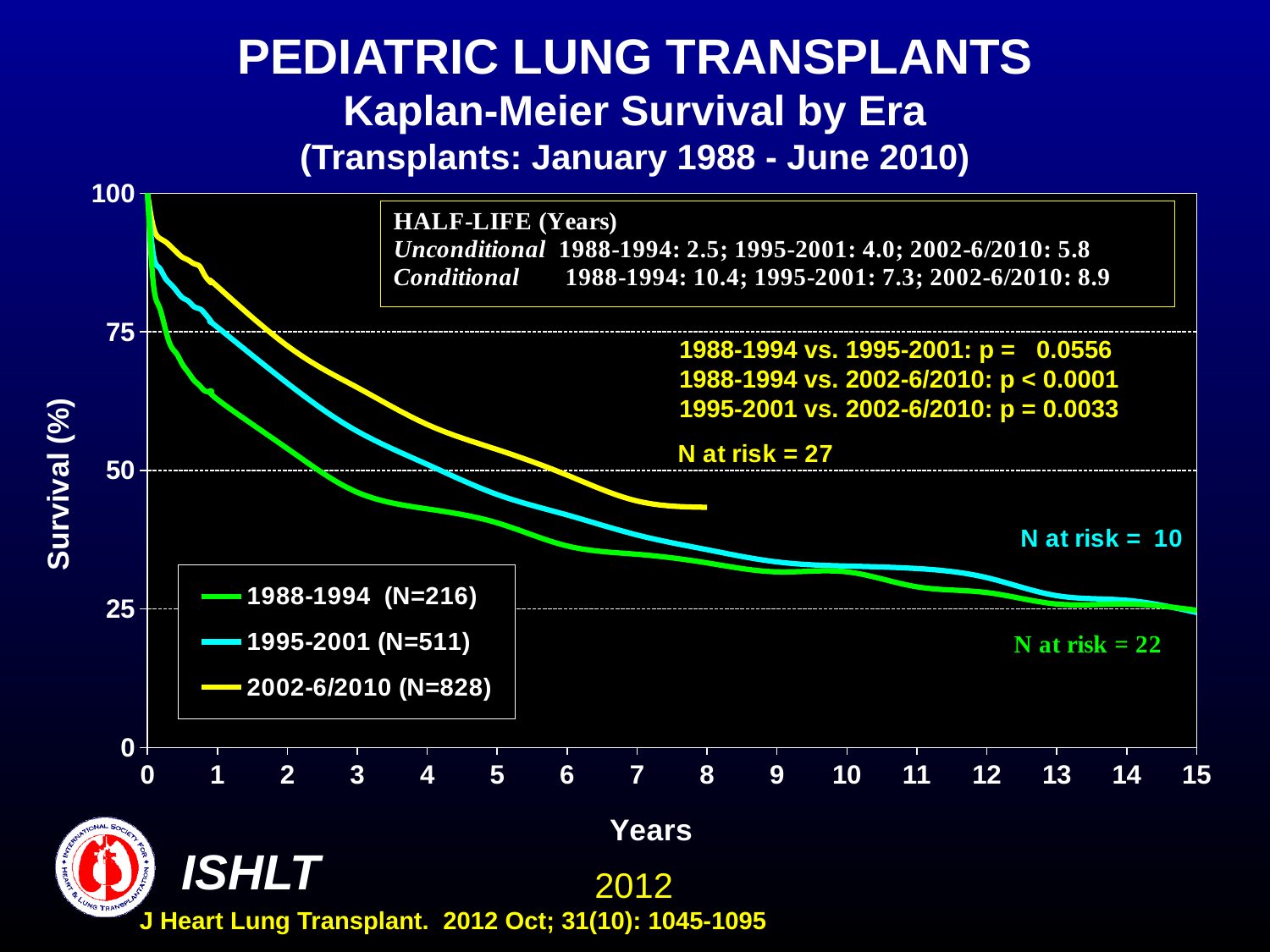
Is the survival for the 1988-1994 era at 5 years greater or less than 50%? less What kind of chart is shown on the slide? line chart At 3 years, which era has higher survival: 1988-1994 or 2002-6/2010? 2002-6/2010 According to the legend, how many transplants (N) are in the 1988-1994 era? 216 Which era has the largest number of transplants (N) in the legend? 2002-6/2010 Do the survival curves rise or fall as years increase? fall According to the legend, how many transplants (N) are in the 2002-6/2010 era? 828 What is the conditional half-life in years for the 1988-1994 era? 10.4 What is the unconditional half-life in years for the 2002-6/2010 era? 5.8 Is the survival for the 2002-6/2010 era at 5 years greater or less than 50%? greater What is the p-value for 1995-2001 vs. 2002-6/2010? 0.0033 How many series (eras) does the legend list? 3